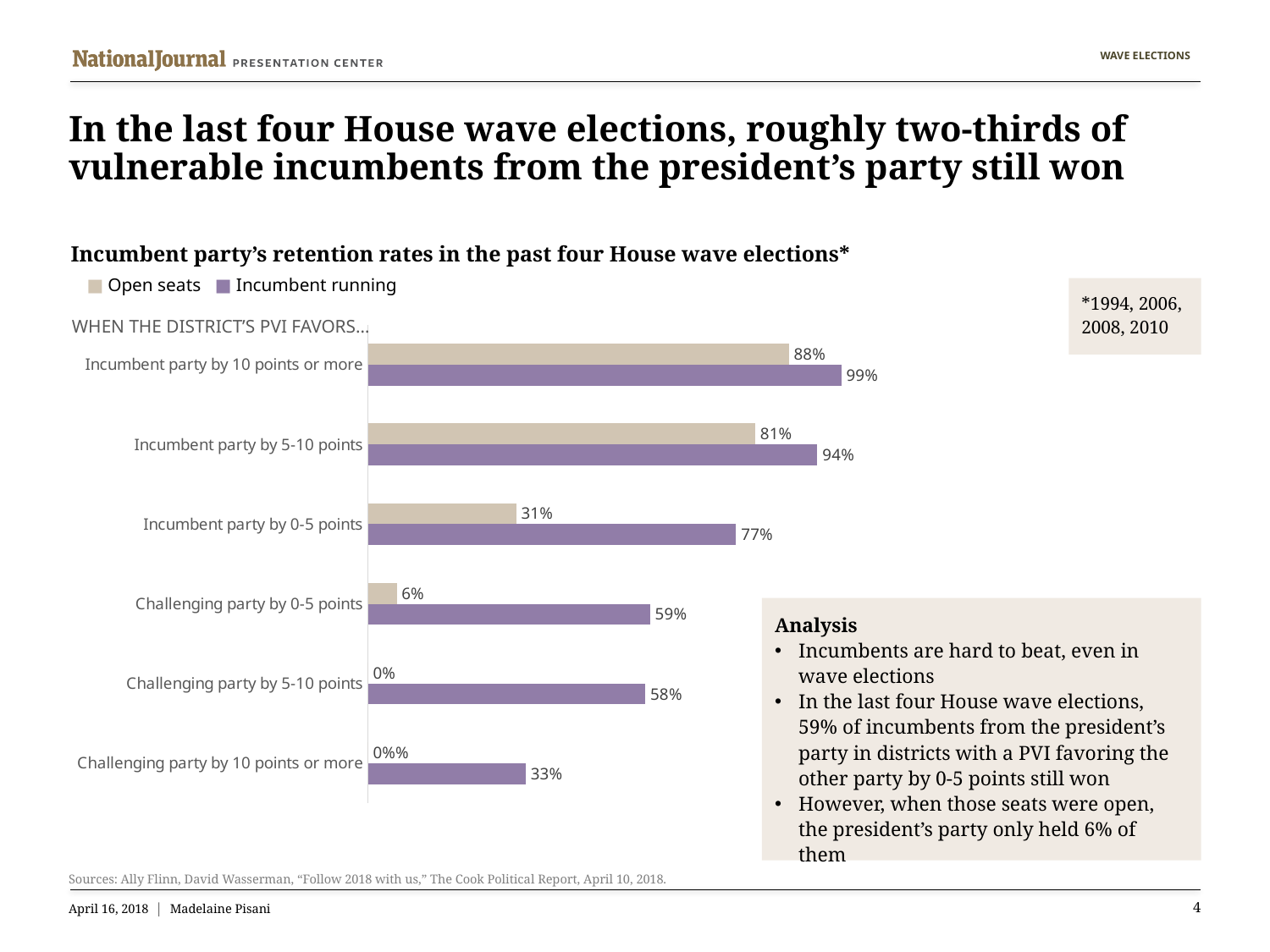
How many series does the legend list? 2 Which series is shown in purple in the legend? Incumbent running What is the Incumbent running retention rate when the district's PVI favors the incumbent party by 10 points or more? 99% What is the Incumbent running retention rate when the district's PVI favors the challenging party by 10 points or more? 33% Which is larger: the Open seats rate for Incumbent party by 10 points or more, or the Incumbent running rate for Incumbent party by 0-5 points? Open seats rate for Incumbent party by 10 points or more Which category has the highest Incumbent running retention rate? Incumbent party by 10 points or more Which category has the lowest Incumbent running retention rate? Challenging party by 10 points or more What is the Open seats retention rate when the district's PVI favors the challenging party by 0-5 points? 6% How many PVI categories are shown on the chart? 6 What kind of chart is shown on the slide? Bar chart What is the difference between the Incumbent running and Open seats retention rates when the PVI favors the incumbent party by 0-5 points? 46% What is the Open seats retention rate when the district's PVI favors the incumbent party by 5-10 points? 81%